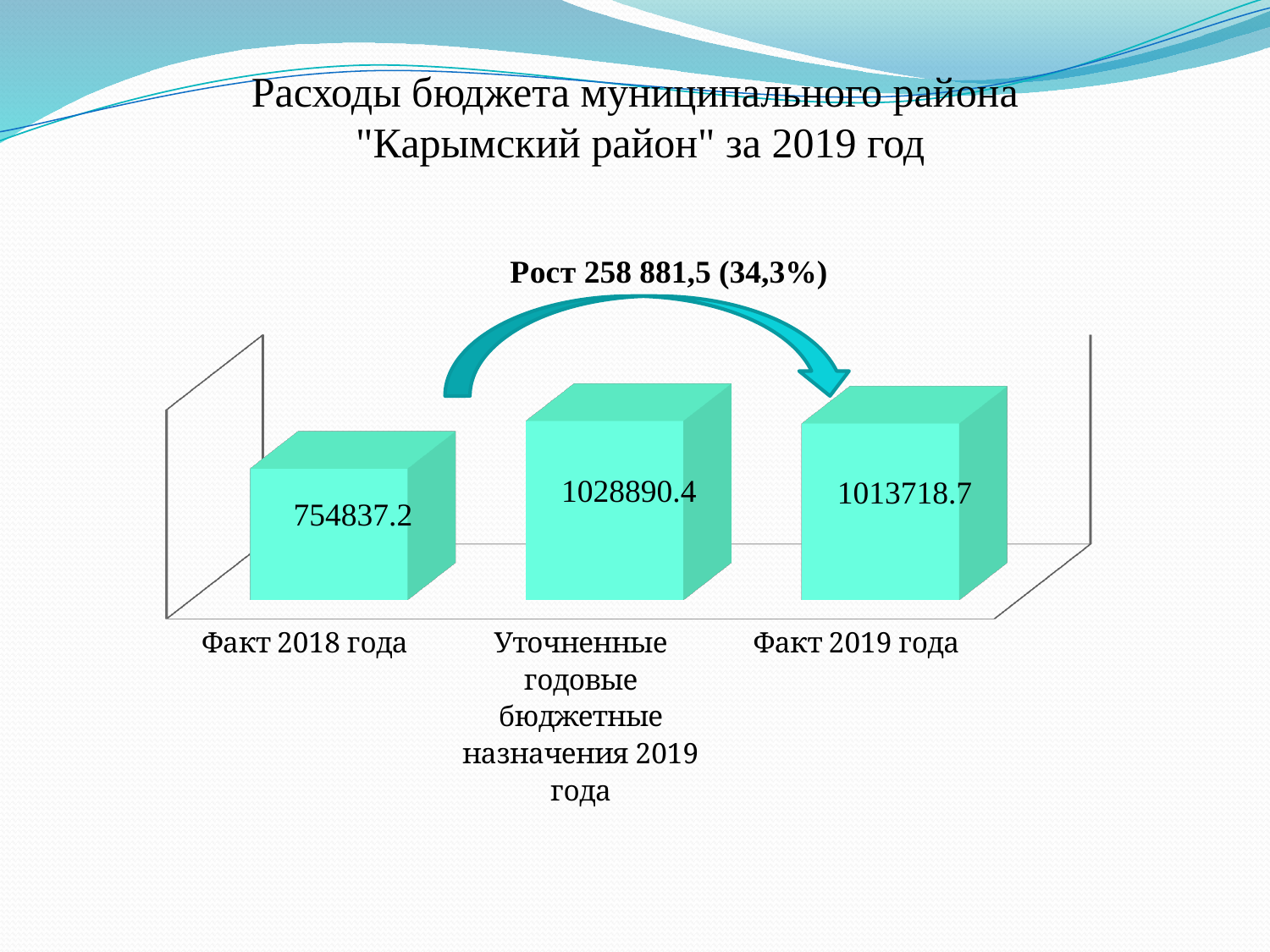
Does the value rise or fall from Факт 2018 года to Факт 2019 года? rise What is the value for Уточненные годовые бюджетные назначения 2019 года? 1028890.4 Which category has the lowest value? Факт 2018 года What is the value for Факт 2018 года? 754837.2 Which category has the highest value? Уточненные годовые бюджетные назначения 2019 года How many categories are shown in the chart? 3 Which is larger, Факт 2018 года or Факт 2019 года? Факт 2019 года What is the value for Факт 2019 года? 1013718.7 What is the difference between Уточненные годовые бюджетные назначения 2019 года and Факт 2019 года? 15171.7 What kind of chart is shown on the slide? bar chart What growth figure is written in the annotation above the chart? Рост 258 881,5 (34,3%) What is the difference between Факт 2019 года and Факт 2018 года? 258881.5